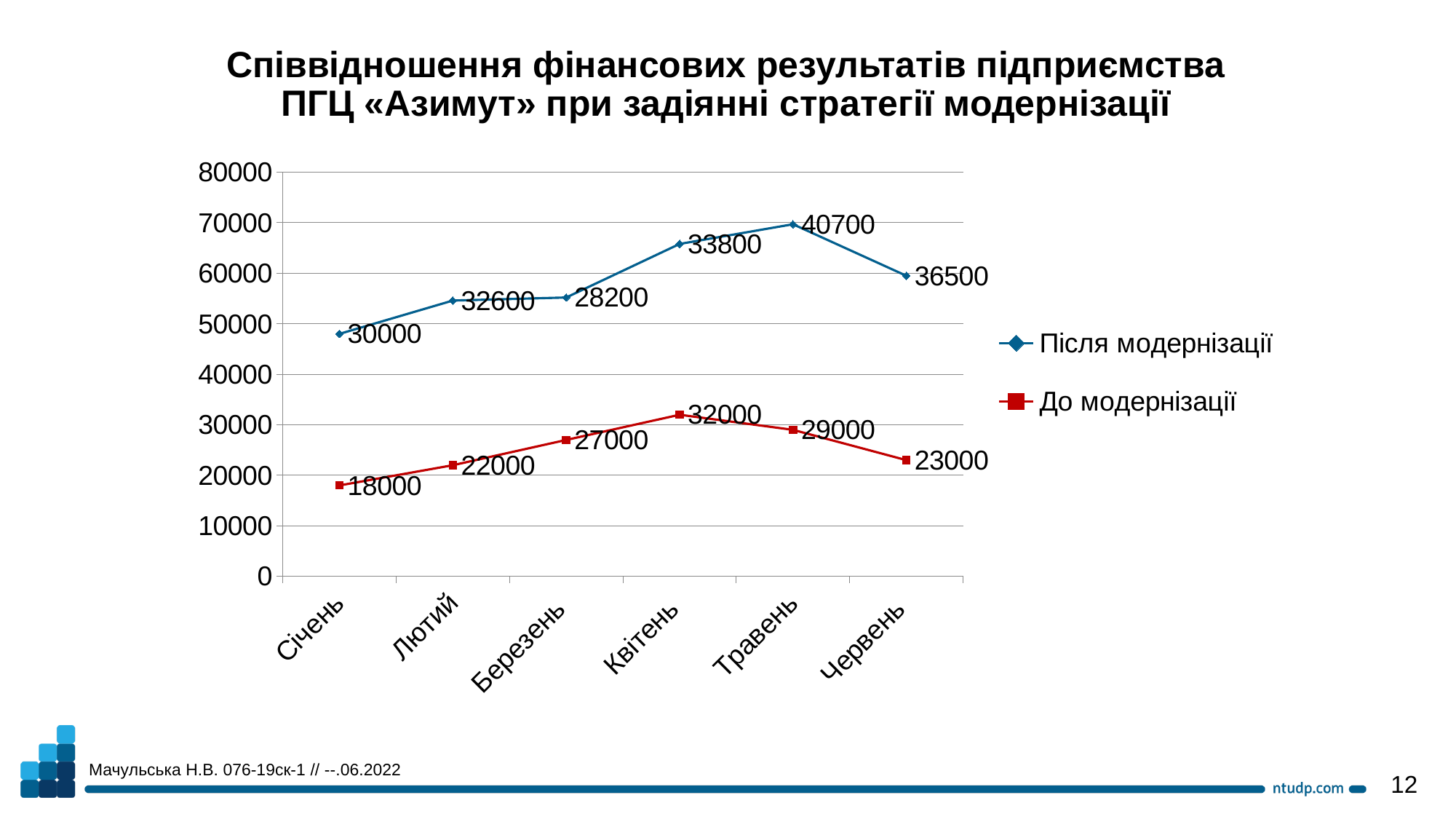
In which month is the value for До модернізації highest? Квітень What is the value for До модернізації in Квітень? 32000 What is the value for До модернізації in Січень? 18000 What is the value for Після модернізації in Червень? 36500 What is the difference between the До модернізації values in Квітень and Січень? 14000 What is the value for Після модернізації in Травень? 40700 Which series has the larger value in Січень, Після модернізації or До модернізації? Після модернізації In which month is the value for До модернізації lowest? Січень What kind of chart is shown on the slide? line chart How many series does the legend list? 2 Does the До модернізації series rise or fall from Квітень to Червень? fall How many months are plotted along the x axis? 6